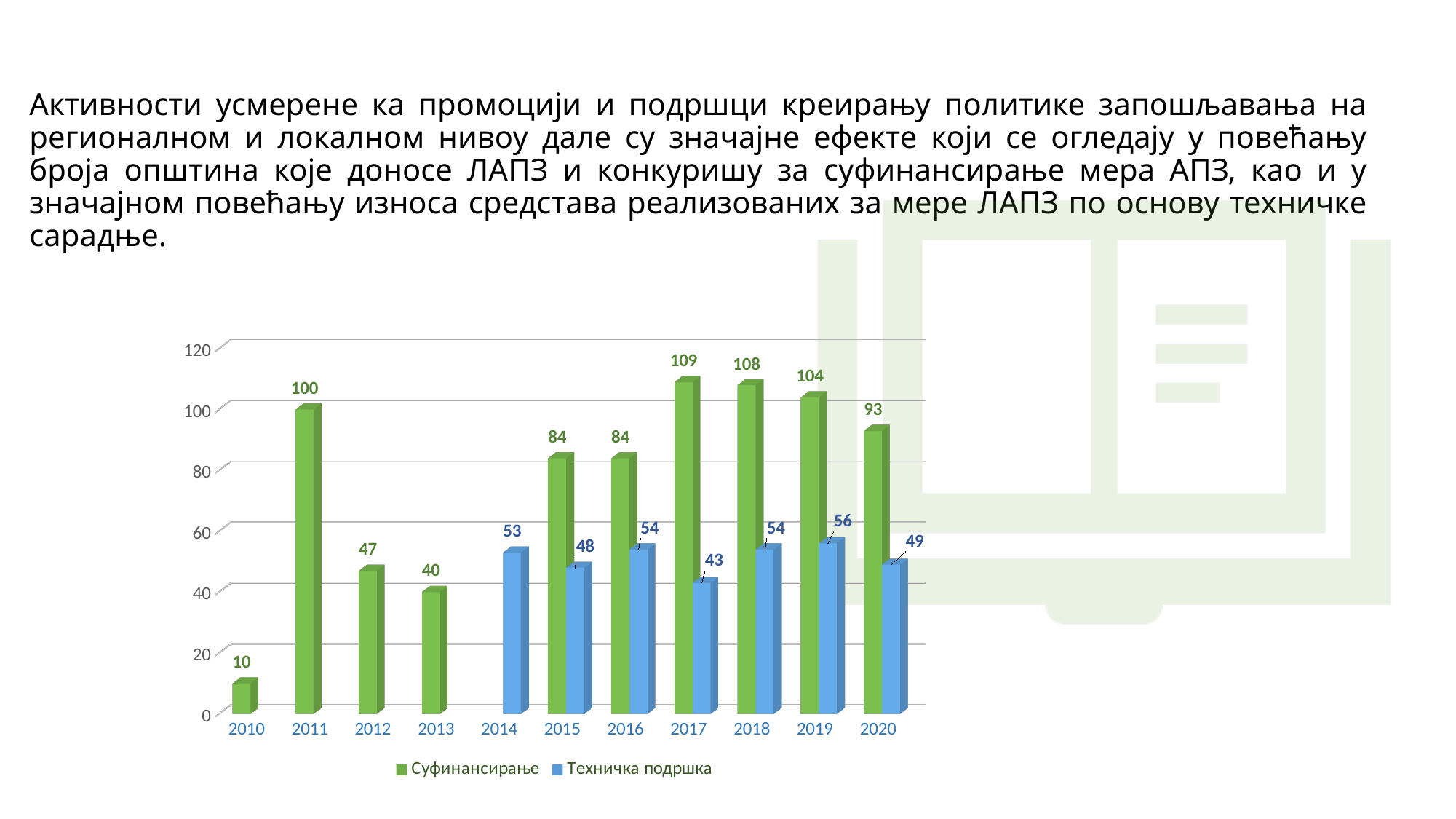
What kind of chart is shown on the slide? Bar chart How many years are shown on the x axis? 11 Which year has the highest value for Суфинансирање? 2017 What is the value for Суфинансирање in 2011? 100 What is the difference between Суфинансирање and Техничка подршка in 2017? 66 Which year has the lowest value for Суфинансирање? 2010 What is the value for Техничка подршка in 2019? 56 Which year has the lowest value for Техничка подршка? 2017 Which is larger in 2015: Суфинансирање or Техничка подршка? Суфинансирање Which colour represents Техничка подршка in the chart? Blue How many series does the legend list? 2 What is the value for Суфинансирање in 2020? 93